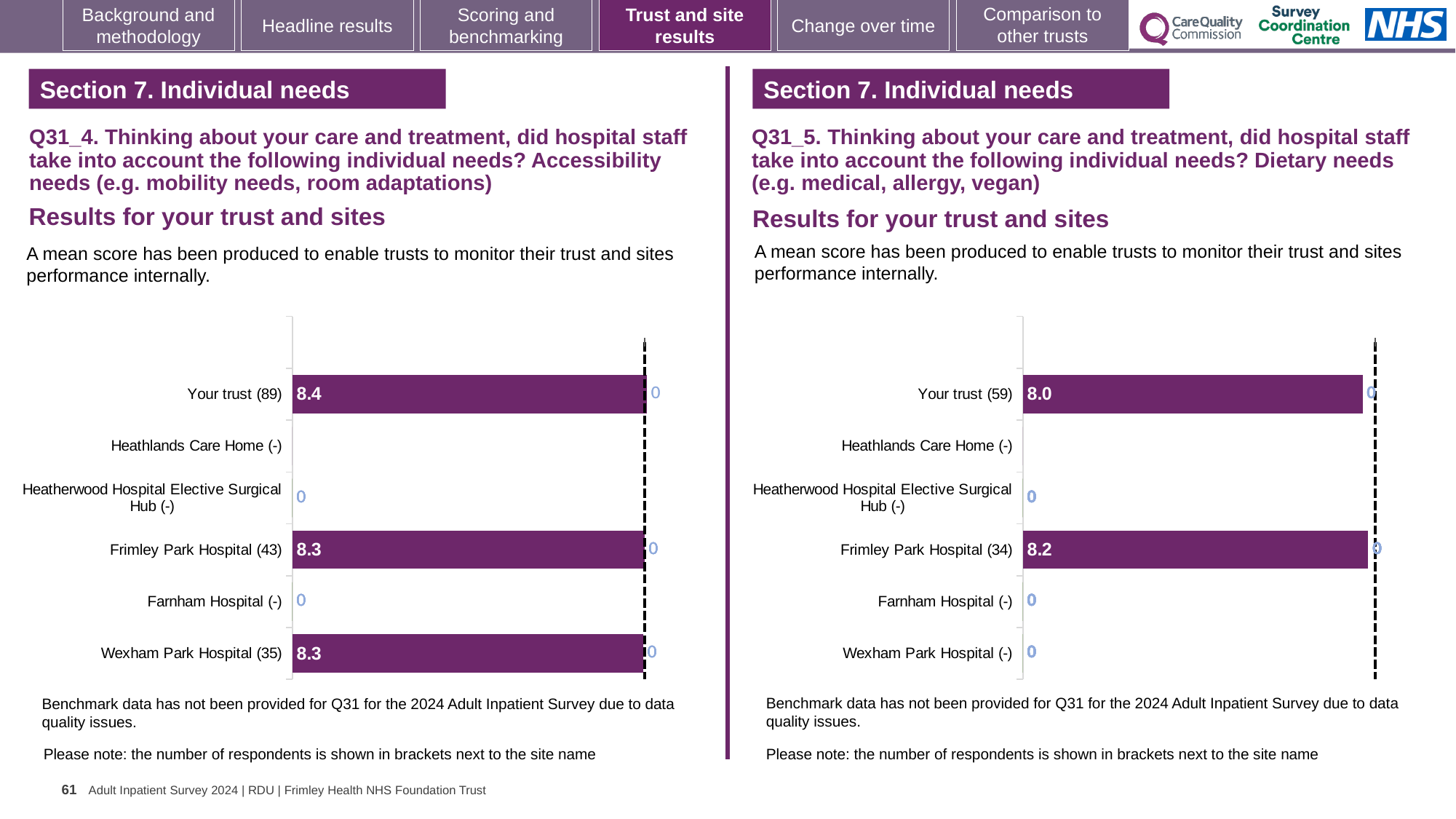
In the Q31_5 Dietary needs chart on the right, what is the difference between the mean score for Frimley Park Hospital and the mean score for Your trust? 0.2 In the Q31_4 Accessibility needs chart on the left, what is the mean score for Frimley Park Hospital? 8.3 In the Q31_5 Dietary needs chart on the right, what is the mean score for Your trust? 8.0 What kind of chart is the Q31_5 Dietary needs chart on the right? Bar chart In the Q31_4 Accessibility needs chart on the left, what is the mean score for Your trust? 8.4 In the Q31_5 Dietary needs chart on the right, how many respondents are shown in brackets for Your trust? 59 In the Q31_4 Accessibility needs chart on the left, which category has the highest mean score? Your trust In the Q31_5 Dietary needs chart on the right, which has the higher mean score, Your trust or Frimley Park Hospital? Frimley Park Hospital How many categories are listed on the vertical axis of the Q31_4 Accessibility needs chart on the left? 6 In the Q31_5 Dietary needs chart on the right, what is the mean score for Frimley Park Hospital? 8.2 In the Q31_4 Accessibility needs chart on the left, what is the difference between the mean score for Your trust and the mean score for Frimley Park Hospital? 0.1 In the Q31_4 Accessibility needs chart on the left, what is the mean score for Wexham Park Hospital? 8.3